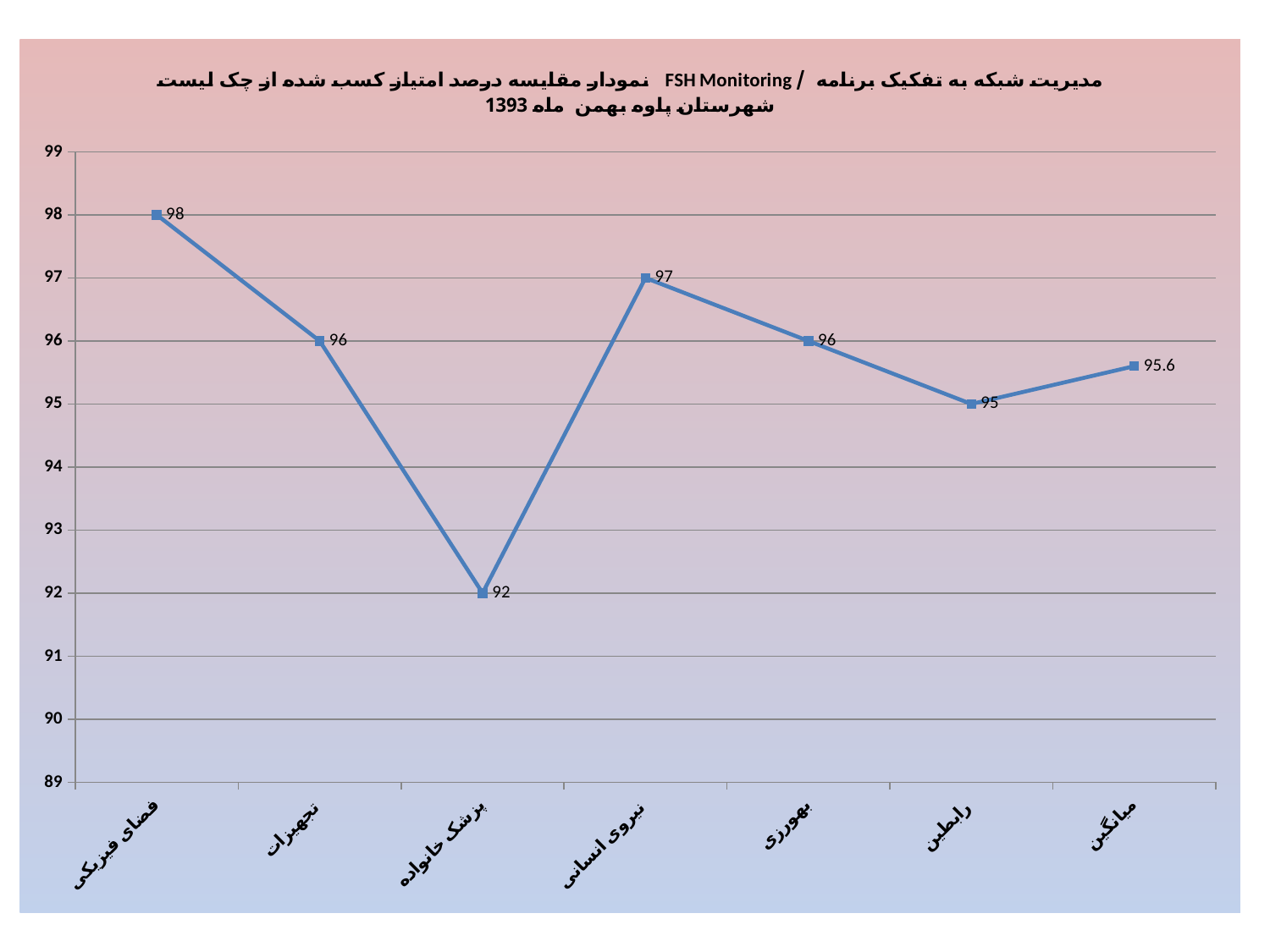
What is the difference between the values for فضای فیزیکی and پزشک خانواده? 6 Which is larger, the value for نیروی انسانی or the value for بهورزی? نیروی انسانی What is the value for فضای فیزیکی? 98 What is the value for میانگین? 95.6 What is the value for پزشک خانواده? 92 Which category has the highest value? فضای فیزیکی What type of chart is shown on the slide? line chart Which category has the lowest value? پزشک خانواده What is the value for رابطین? 95 Does the line rise or fall from فضای فیزیکی to پزشک خانواده? fall What is the difference between the values for نیروی انسانی and رابطین? 2 How many categories are plotted on the x axis? 7